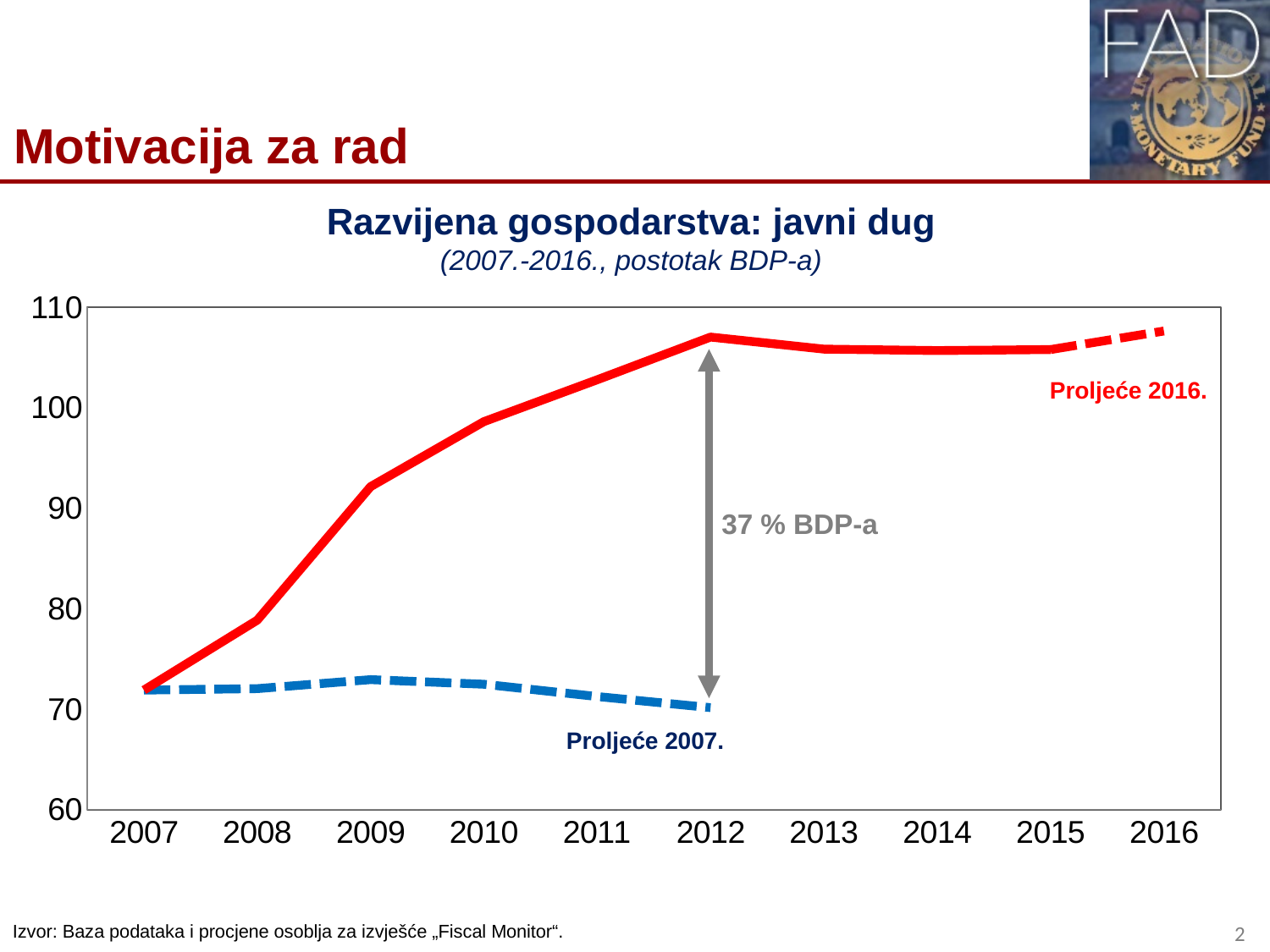
How many years are shown on the x axis of the chart? 10 Is the value of the Proljeće 2016. series in 2010 greater or less than 90? greater What is the title of the chart? Razvijena gospodarstva: javni dug What gap between the two series is labelled on the chart at 2012? 37 % BDP-a What kind of chart is shown on the slide? line chart In which year does the Proljeće 2016. series have its lowest value? 2007 How many data series are plotted on the chart? 2 In 2012, which series has the higher value, Proljeće 2016. or Proljeće 2007.? Proljeće 2016. Is the value of the Proljeće 2016. series in 2012 greater or less than 100? greater Does the Proljeće 2016. series rise or fall between 2007 and 2012? rise Is the value of the Proljeće 2016. series in 2008 greater or less than 90? less